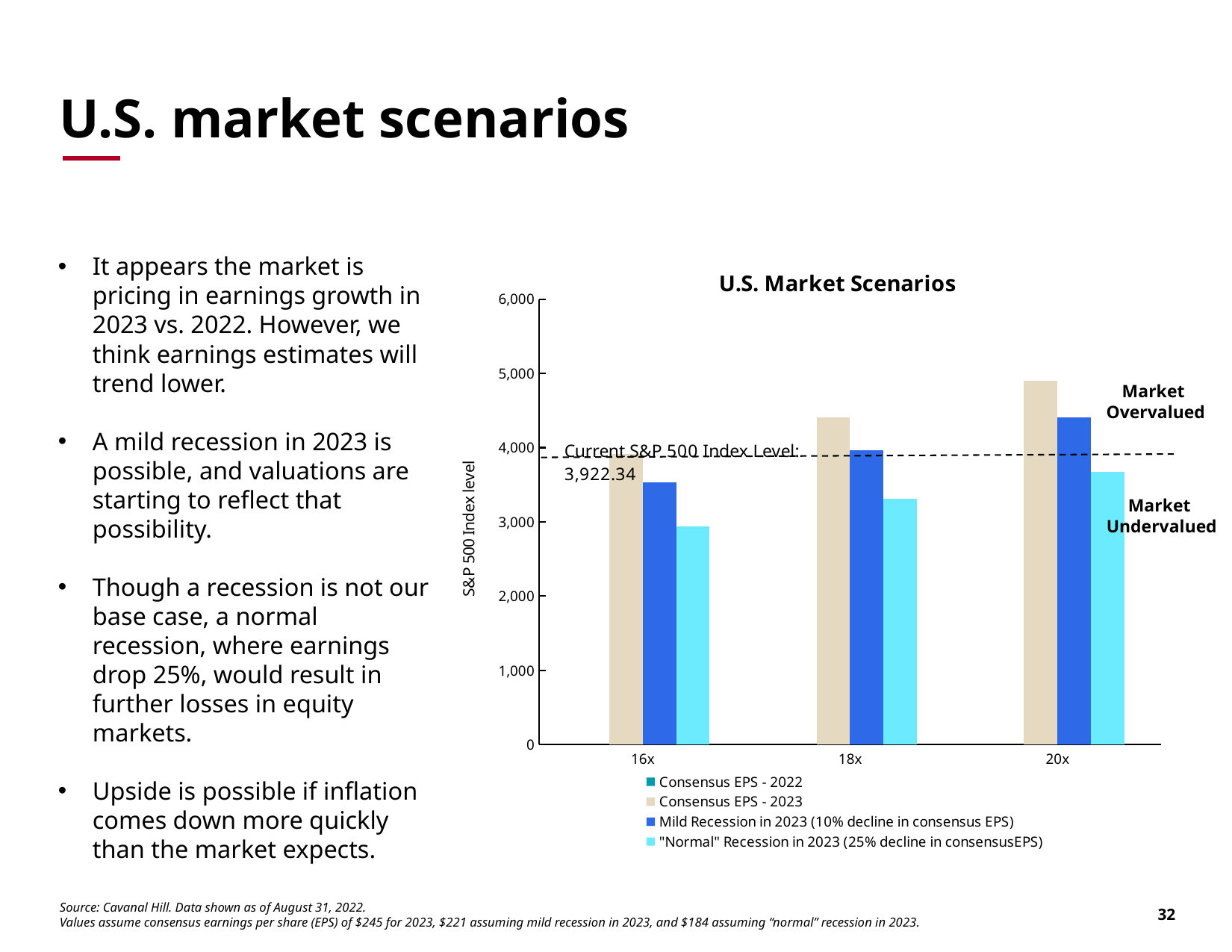
Is the Mild Recession in 2023 value at 16x greater or less than 4,000? less Is the Consensus EPS - 2023 value at 20x greater or less than 4,000? greater At which multiple (16x, 18x or 20x) is the Consensus EPS - 2023 bar the highest? 20x How many series does the legend of the U.S. Market Scenarios chart list? 4 What is the label on the vertical axis of the chart? S&P 500 Index level What kind of chart is shown on the slide? bar chart How many categories are shown on the x axis of the U.S. Market Scenarios chart? 3 Which series has the lowest bar at 18x? "Normal" Recession in 2023 (25% decline in consensus EPS) What is the current S&P 500 index level marked by the dashed line on the chart? 3,922.34 Is the "Normal" Recession in 2023 value at 20x greater or less than 3,000? greater Do the Mild Recession in 2023 bars rise or fall from 16x to 20x? rise